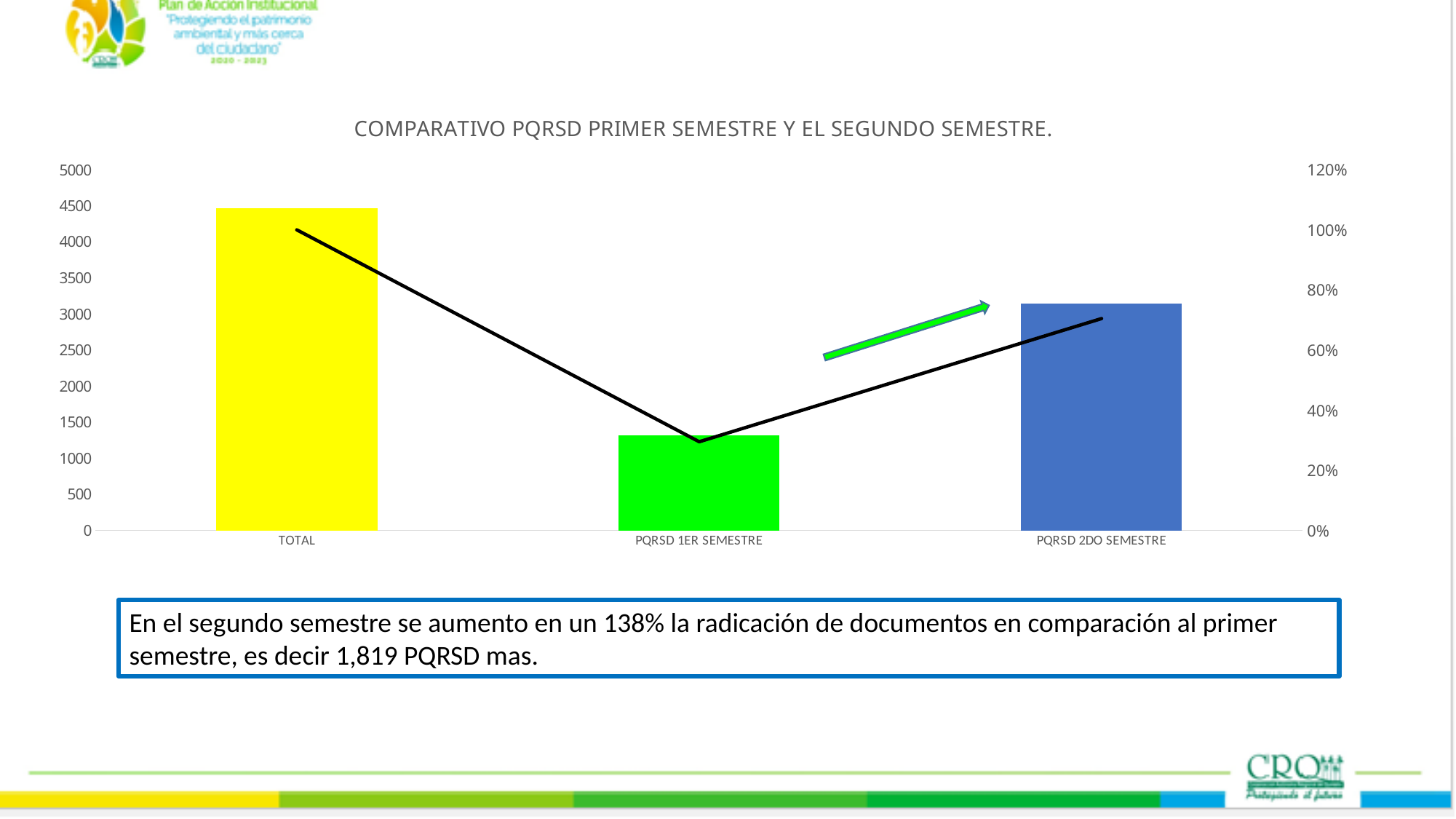
Which category has the tallest bar? TOTAL What is the highest tick value shown on the right-hand percentage axis? 120% What type of chart is shown on the slide? Combination bar and line chart What is the title of the chart? COMPARATIVO PQRSD PRIMER SEMESTRE Y EL SEGUNDO SEMESTRE. Does the black line fall or rise from TOTAL to PQRSD 1ER SEMESTRE? fall How many categories are shown on the x axis of the chart? 3 Is the value for PQRSD 1ER SEMESTRE greater or less than 1500? less Is the value for TOTAL greater or less than 4000? greater Which bar is taller, PQRSD 1ER SEMESTRE or PQRSD 2DO SEMESTRE? PQRSD 2DO SEMESTRE Which category has the shortest bar? PQRSD 1ER SEMESTRE What colour is the bar for PQRSD 2DO SEMESTRE? Blue Is the value for PQRSD 2DO SEMESTRE greater or less than 2500? greater